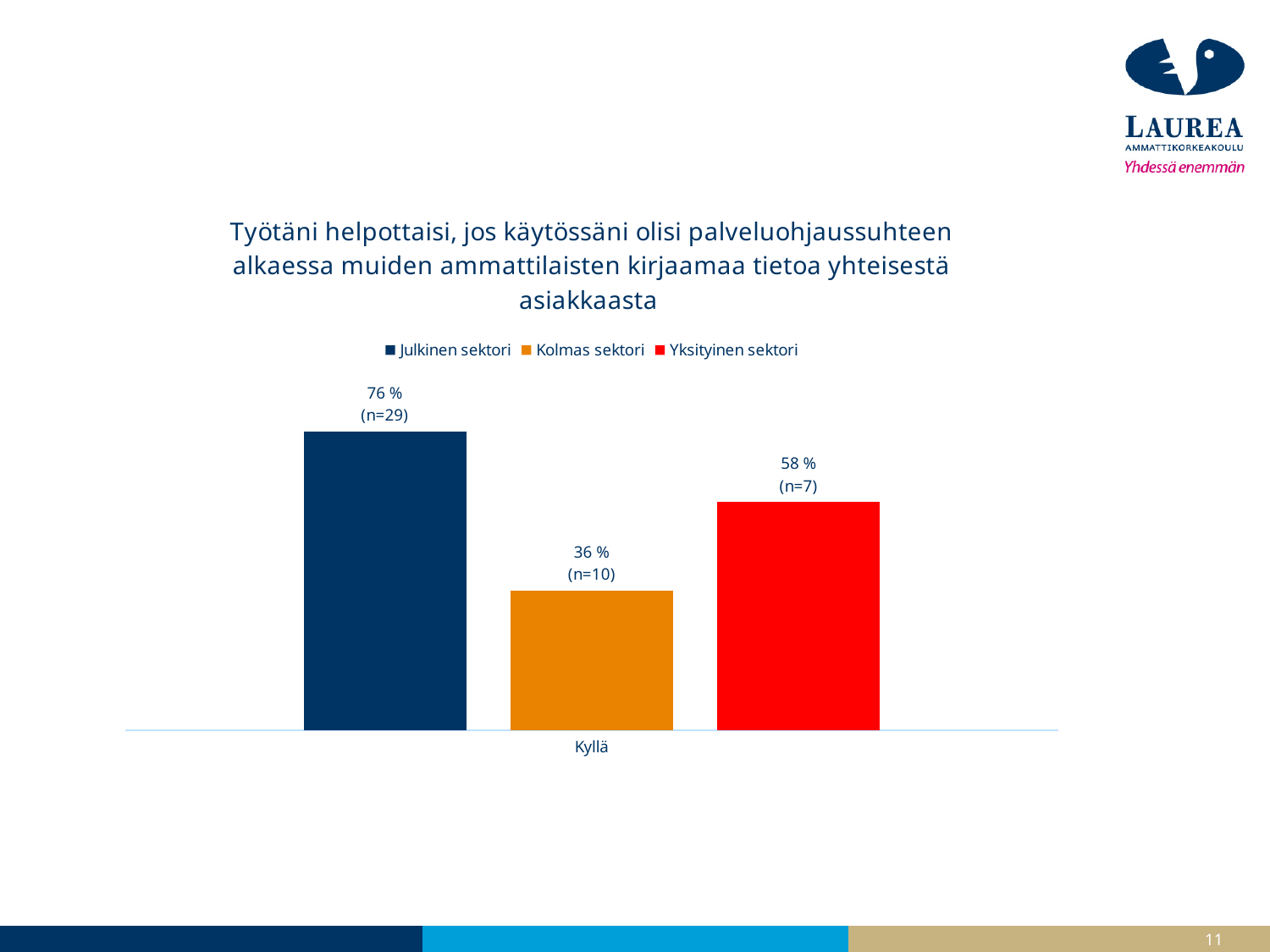
Which is larger, the percentage for Yksityinen sektori or for Kolmas sektori? Yksityinen sektori What percentage is shown for Yksityinen sektori? 58 % Which sector has the highest percentage? Julkinen sektori How many series does the legend list? 3 Which sector has the lowest percentage? Kolmas sektori What is the n value shown for Julkinen sektori? n=29 What is the n value shown for Yksityinen sektori? n=7 What kind of chart is shown on the slide? Bar chart What is the category label shown on the x axis? Kyllä What is the difference in percentage points between Julkinen sektori and Kolmas sektori? 40 What percentage is shown for Julkinen sektori? 76 % What percentage is shown for Kolmas sektori? 36 %